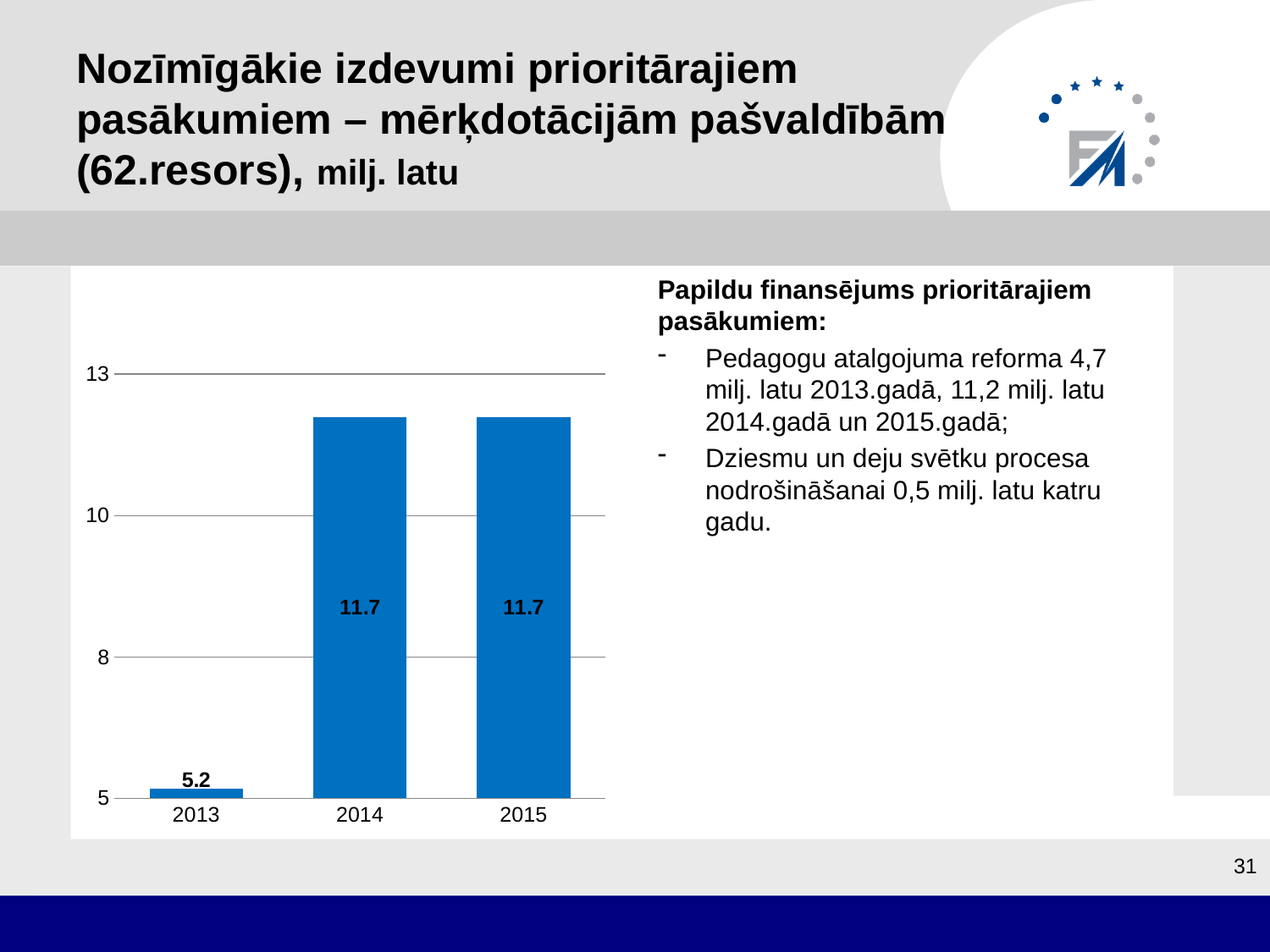
How many years are shown on the x axis? 3 What is the value for 2013? 5.2 What is the difference between the values for 2014 and 2013? 6.5 What is the value for 2014? 11.7 What is the highest value shown on the y axis? 13 Which year has the lowest value? 2013 Do the values rise or fall from 2013 to 2014? rise What kind of chart is shown on the slide? bar chart What is the value for 2015? 11.7 Which is larger, the value for 2013 or the value for 2015? 2015 Is the value for 2014 greater or less than 10? greater Is the value for 2013 greater or less than 8? less